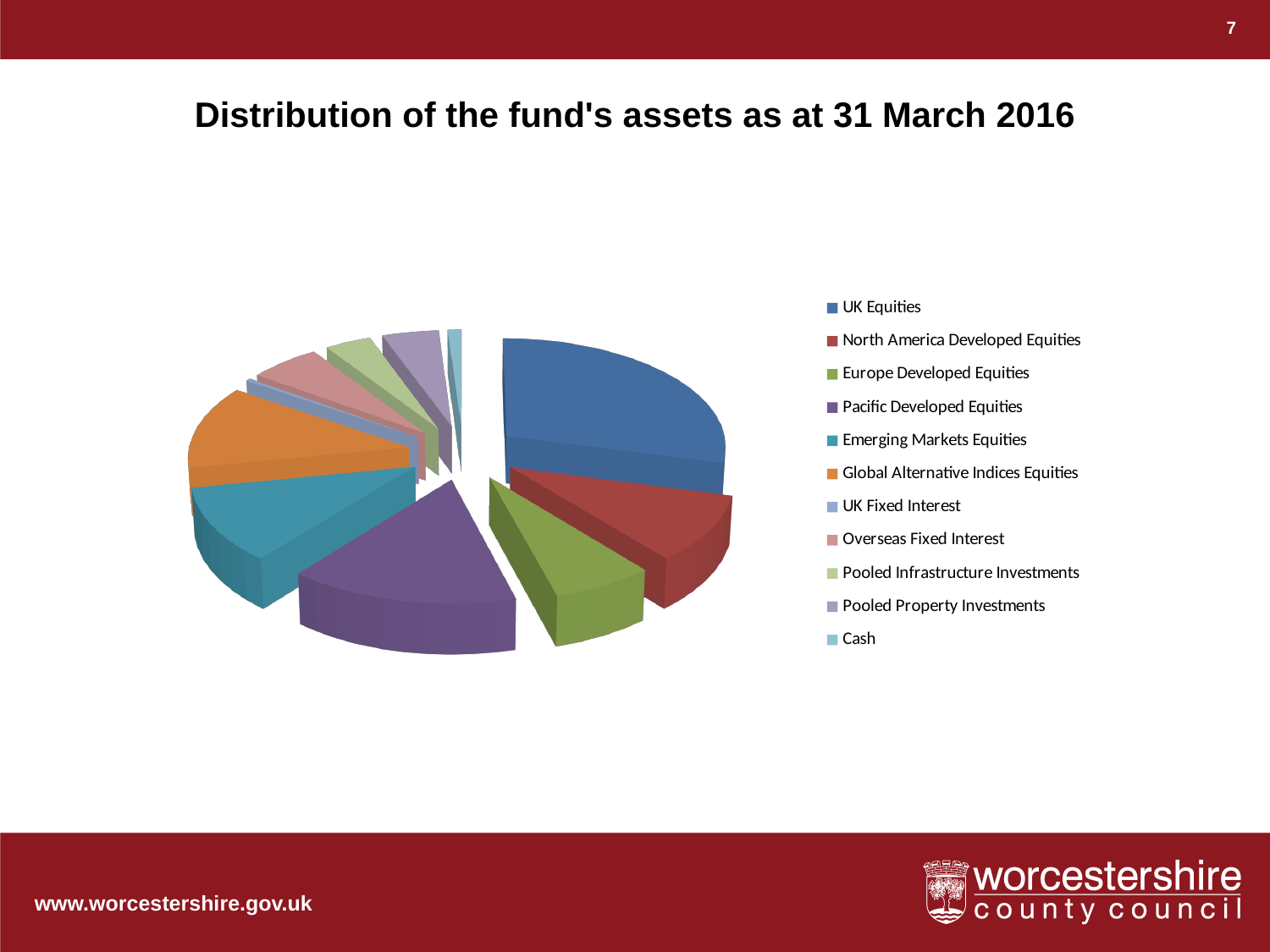
Which slice is larger, Emerging Markets Equities or Pooled Infrastructure Investments? Emerging Markets Equities Which legend entry is listed last in the pie chart's legend? Cash Which asset category has the largest slice of the pie chart? UK Equities Which slice is larger, Pacific Developed Equities or Cash? Pacific Developed Equities What is the title of the chart on the slide? Distribution of the fund's assets as at 31 March 2016 Which slice is larger, UK Equities or Europe Developed Equities? UK Equities What kind of chart is shown on the slide? Pie chart How many asset categories does the pie chart's legend list? 11